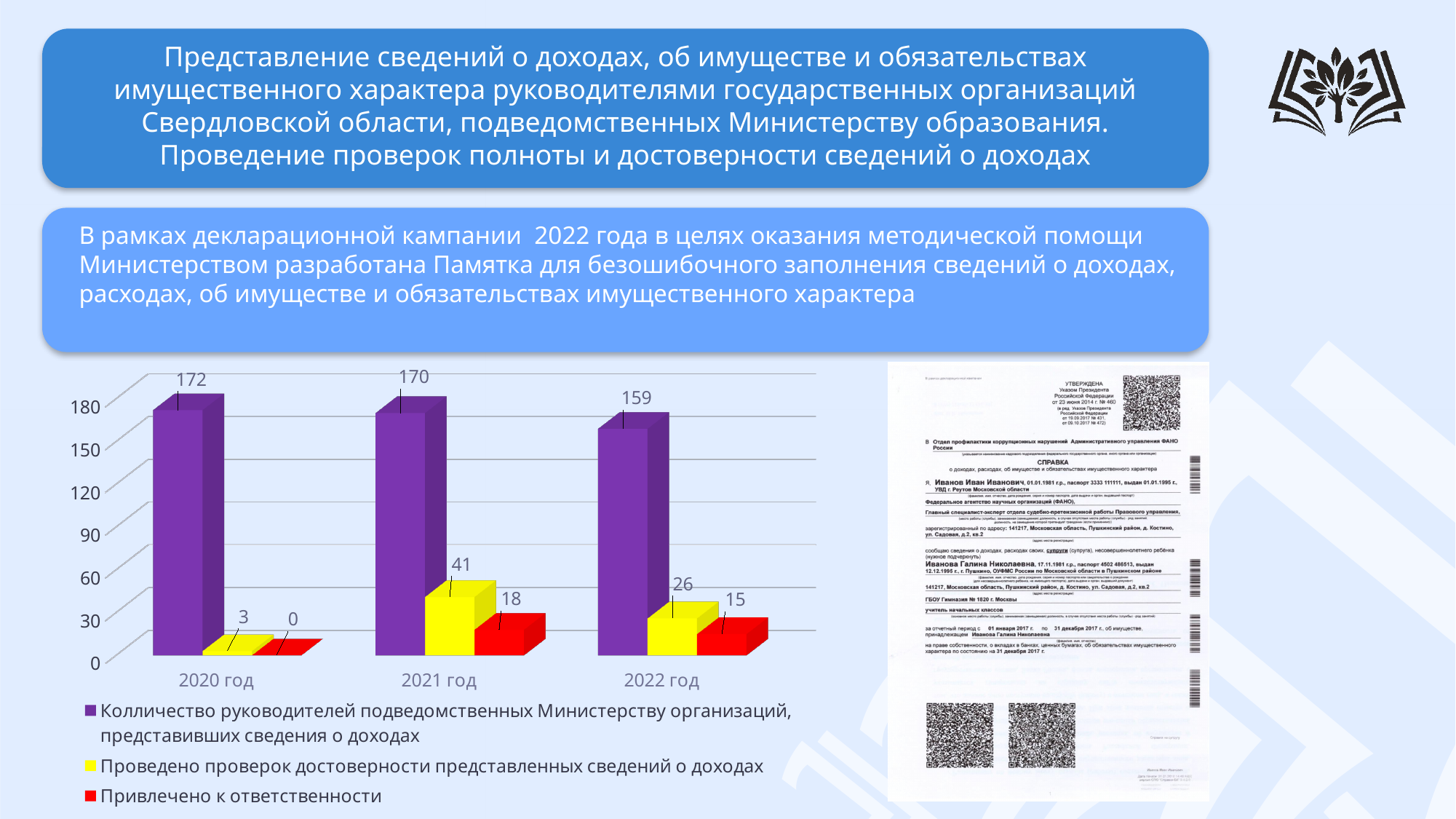
What is the value for Привлечено к ответственности in 2020 год? 0 How many series does the chart legend list? 3 Which is larger: the number of accuracy checks in 2021 год or in 2022 год? 2021 год How many years (categories) are shown on the x axis of the chart? 3 Does the number of heads who submitted income information (purple series) rise or fall from 2020 год to 2022 год? Fall In which year was the number of heads who submitted income information (purple series) the lowest? 2022 год What is the difference between the number of heads who submitted income information in 2020 год and in 2022 год? 13 What is the value for Привлечено к ответственности in 2022 год? 15 What is the number of heads of organisations who submitted income information (Колличество руководителей...) in 2020 год? 172 How many checks of the accuracy of submitted income information (Проведено проверок достоверности...) were carried out in 2021 год? 41 In which year was the number of accuracy checks (yellow series) the highest? 2021 год What type of chart is shown on the slide? Bar chart